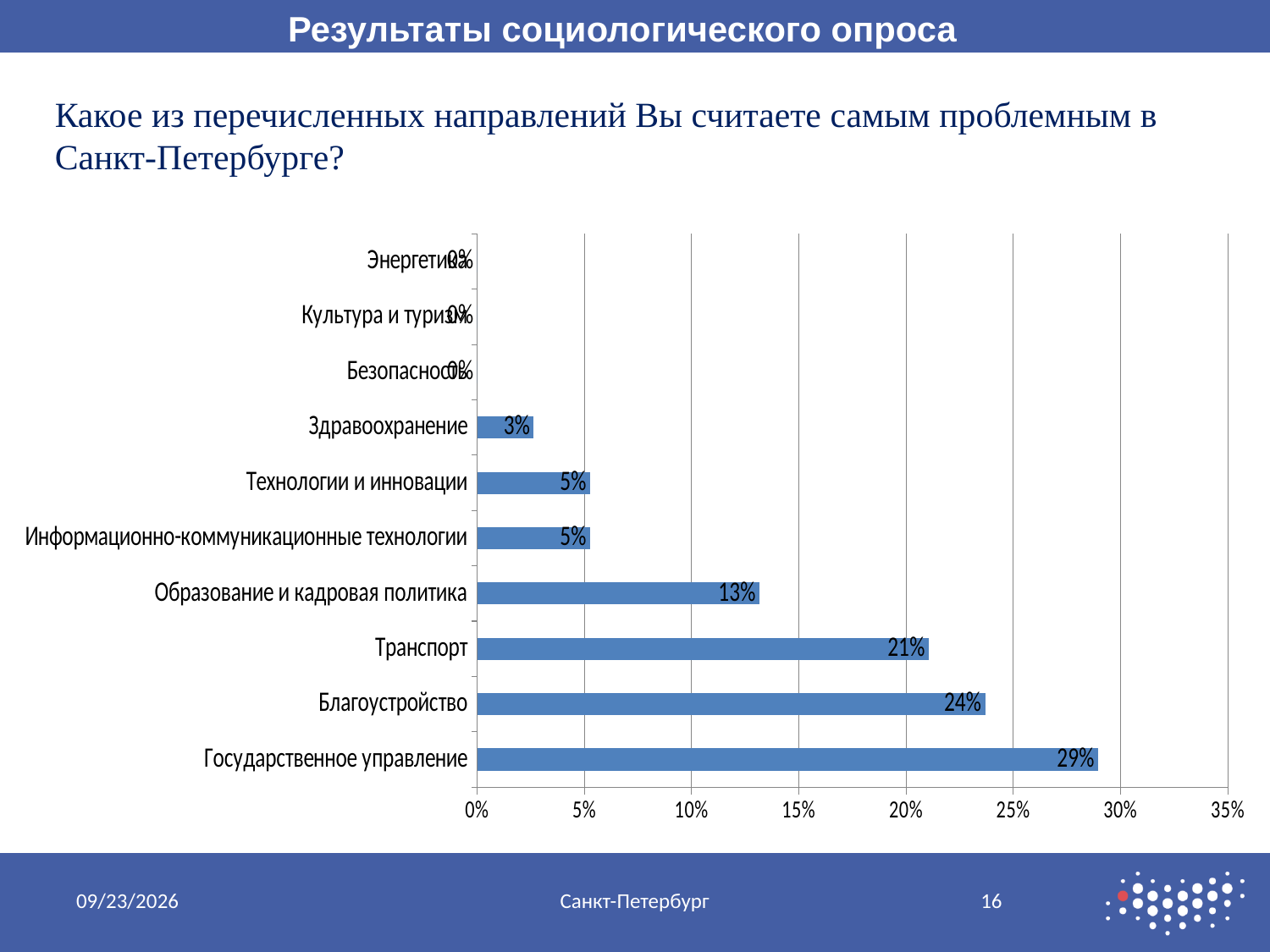
Which category has the highest value? Государственное управление What kind of chart is shown on the slide? bar chart What is the difference between the values for Транспорт and Образование и кадровая политика? 8% Is the value for Благоустройство greater or less than 20%? greater Which is larger, the value for Благоустройство or the value for Транспорт? Благоустройство How many categories are shown in the chart? 10 What is the value for Образование и кадровая политика? 13% What is the maximum value shown on the horizontal axis? 35% What is the difference between the values for Государственное управление and Благоустройство? 5% What is the value for Транспорт? 21% What is the value for Здравоохранение? 3% What is the value for Государственное управление? 29%